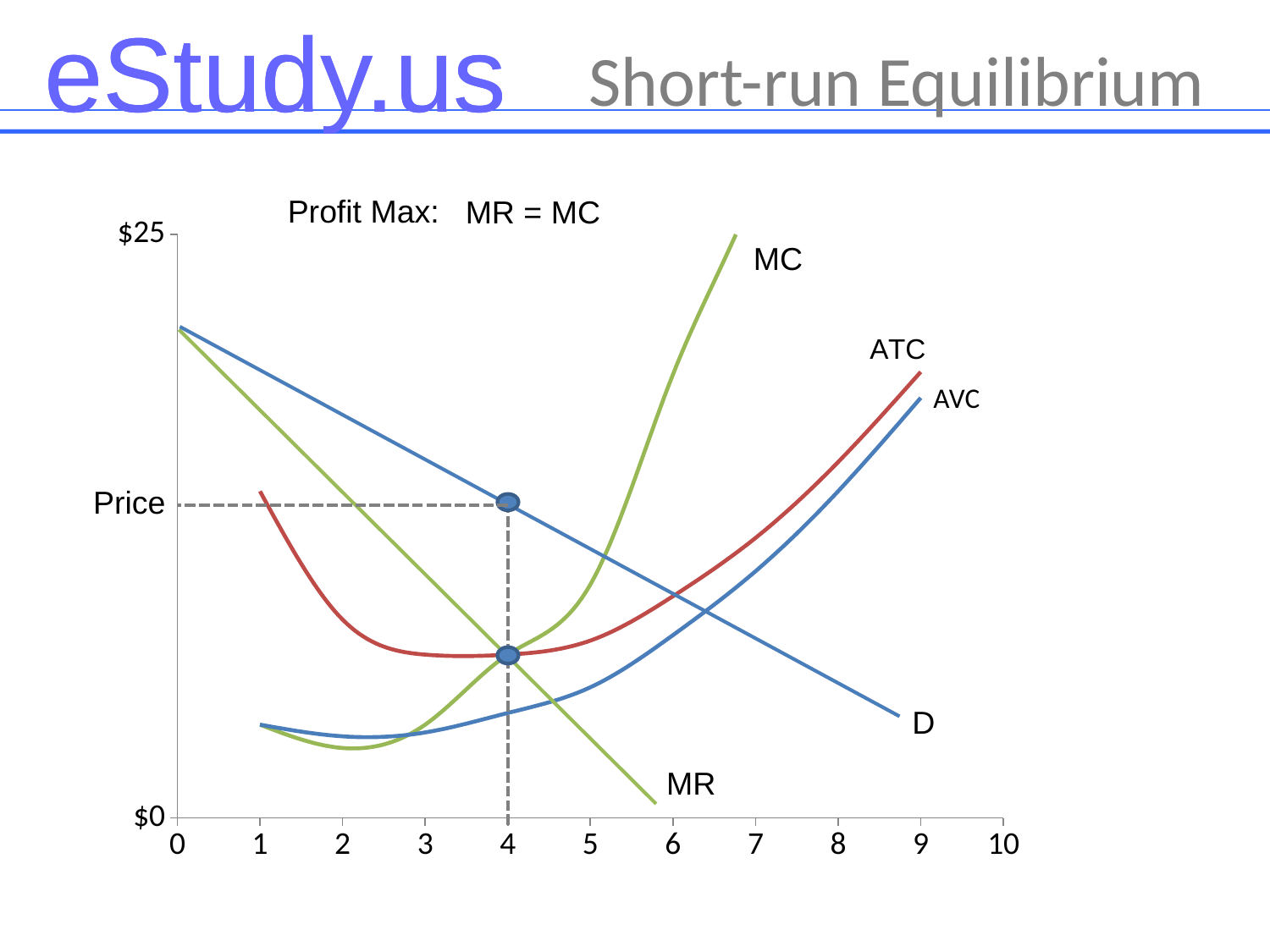
Is the Price marked by the dashed horizontal line greater or less than $25? less What is the highest value labeled on the y axis? $25 What is the largest quantity labeled on the x axis? 10 Does the MR curve rise or fall as quantity increases? fall Does the D curve rise or fall as quantity increases? fall Which curve reaches the highest point on the chart? MC At what quantity on the x axis does the dashed vertical line mark the MR = MC point? 4 At quantity 4, which is higher: the D curve or the ATC curve? D How many curves are labeled on the chart? 5 What profit-maximizing condition is written above the chart? MR = MC Which curve lies below the ATC curve across the plotted range? AVC What kind of chart is shown on the slide? line chart